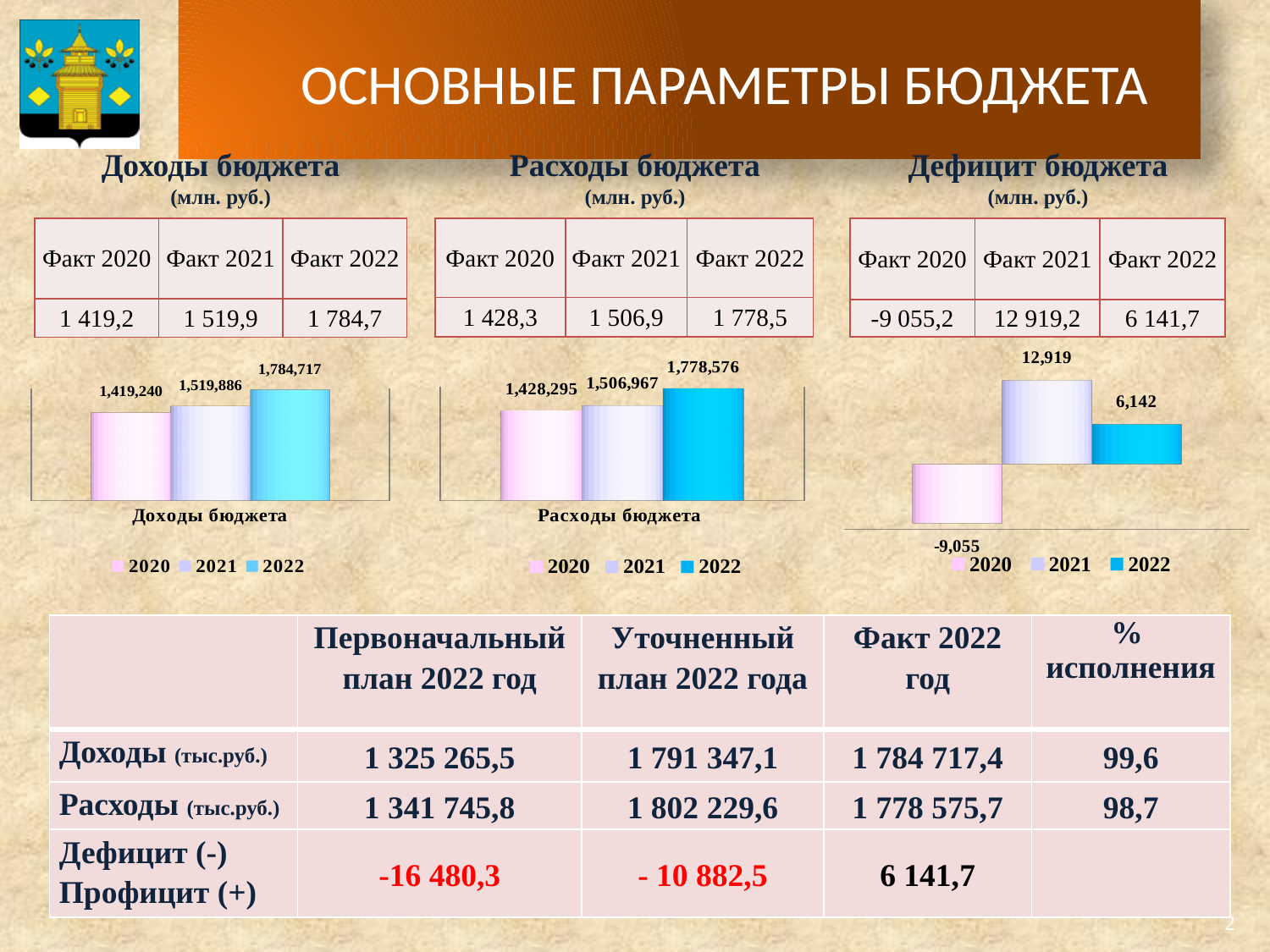
In the right chart (Дефицит бюджета), which year has the highest value? 2021 In the middle chart (Расходы бюджета), what is the data label for 2021? 1,506,967 In the middle chart (Расходы бюджета), which is larger: the 2022 value or the 2020 value? 2022 In the right chart (Дефицит бюджета), what is the difference between the 2021 and 2022 values? 6,777 In the left chart (Доходы бюджета), do the values rise or fall from 2020 to 2022? Rise In the left chart (Доходы бюджета), what is the difference between the 2022 and 2020 values? 365,477 In the left chart (Доходы бюджета), which year has the lowest value? 2020 In the right chart (Дефицит бюджета), what is the data label for 2020? -9,055 What kind of chart is the left chart (Доходы бюджета)? Bar chart In the left chart (Доходы бюджета), what is the data label for 2020? 1,419,240 In the left chart (Доходы бюджета), what is the data label for 2022? 1,784,717 How many series does the legend of the middle chart (Расходы бюджета) list? 3